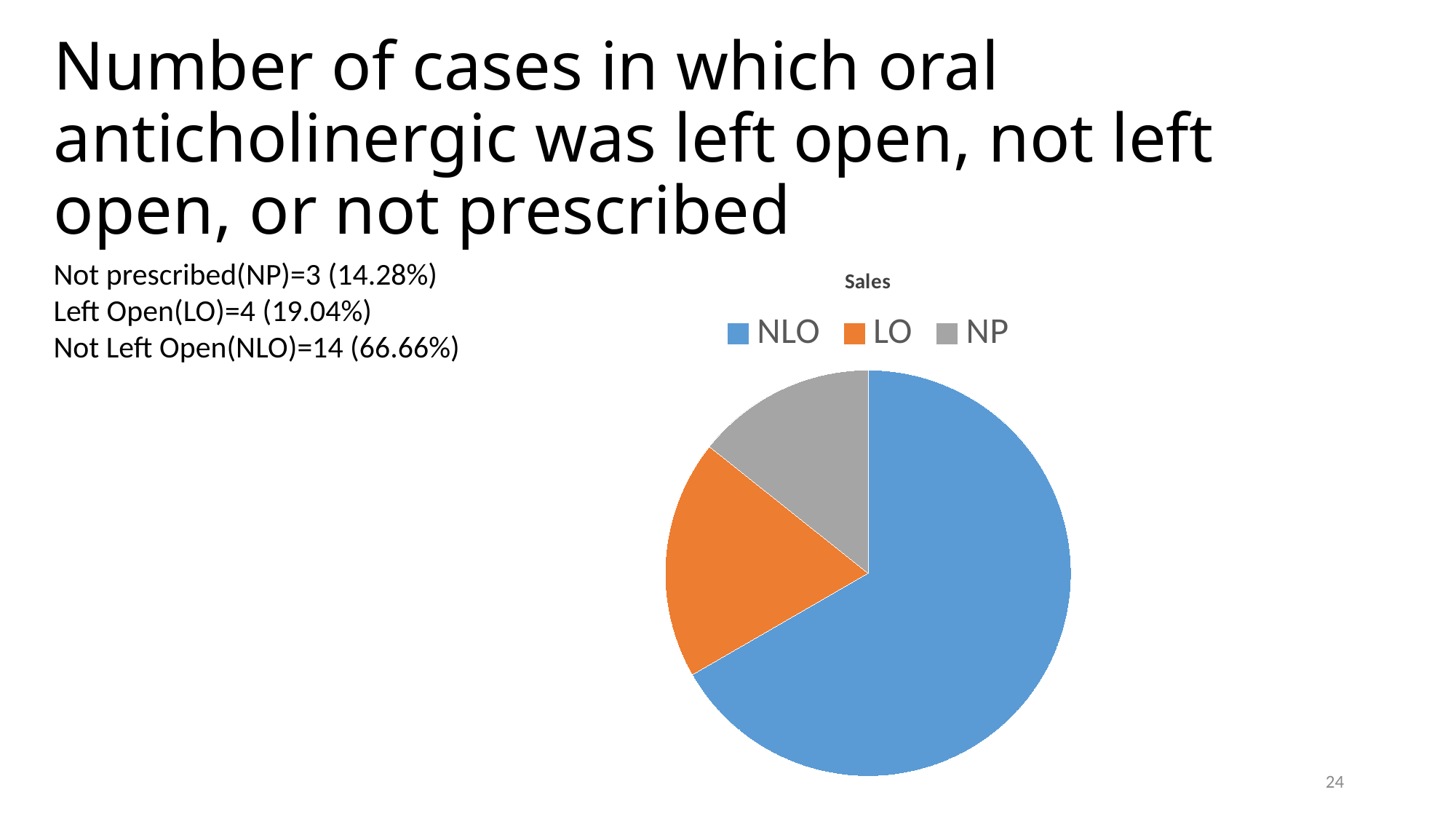
Which category has the smallest slice of the pie chart? NP What is the title shown above the pie chart? Sales How many cases are in the Not Left Open (NLO) category? 14 What percentage share of the pie does the Not prescribed (NP) slice represent? 14.28% What kind of chart is shown on the slide? pie chart How many slices does the pie chart have? 3 What is the difference in number of cases between NLO and LO? 10 Which has more cases, LO or NP? LO How many cases are in the Left Open (LO) category? 4 How many entries does the legend of the pie chart list? 3 What percentage share of the pie does the NLO slice represent? 66.66% Which category has the largest slice of the pie chart? NLO